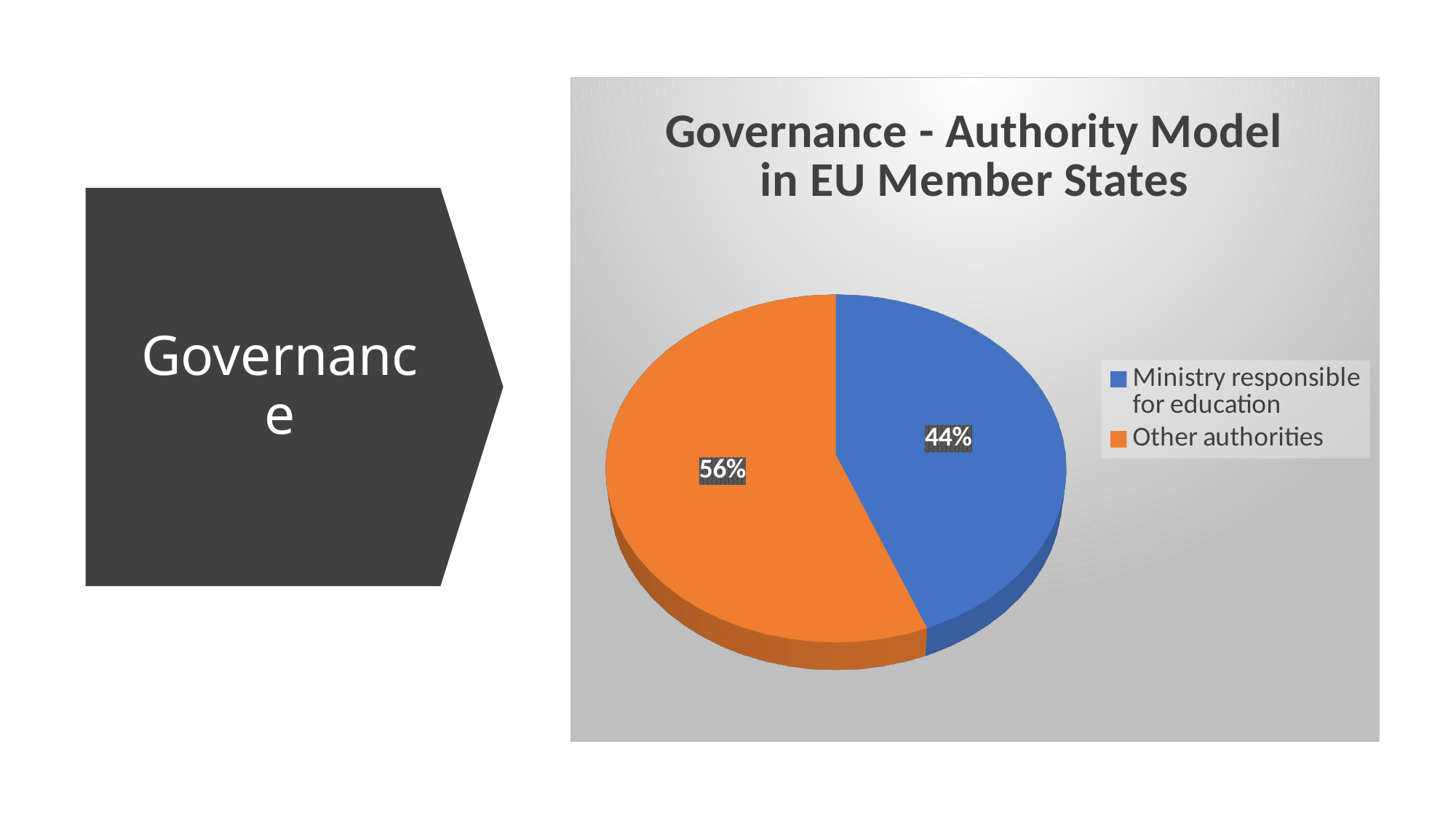
What is the title of the chart? Governance - Authority Model in EU Member States Which category has the smallest slice of the pie? Ministry responsible for education How many slices does the pie chart have? 2 What is the difference in percentage points between the Other authorities slice and the Ministry responsible for education slice? 12 How many entries does the legend list? 2 What share of the pie is labelled for Ministry responsible for education? 44% Which category has the largest slice of the pie? Other authorities Which is larger: the slice for Ministry responsible for education or the slice for Other authorities? Other authorities What share of the pie is labelled for Other authorities? 56% What kind of chart is shown on the slide? Pie chart What colour is the slice for Other authorities? Orange